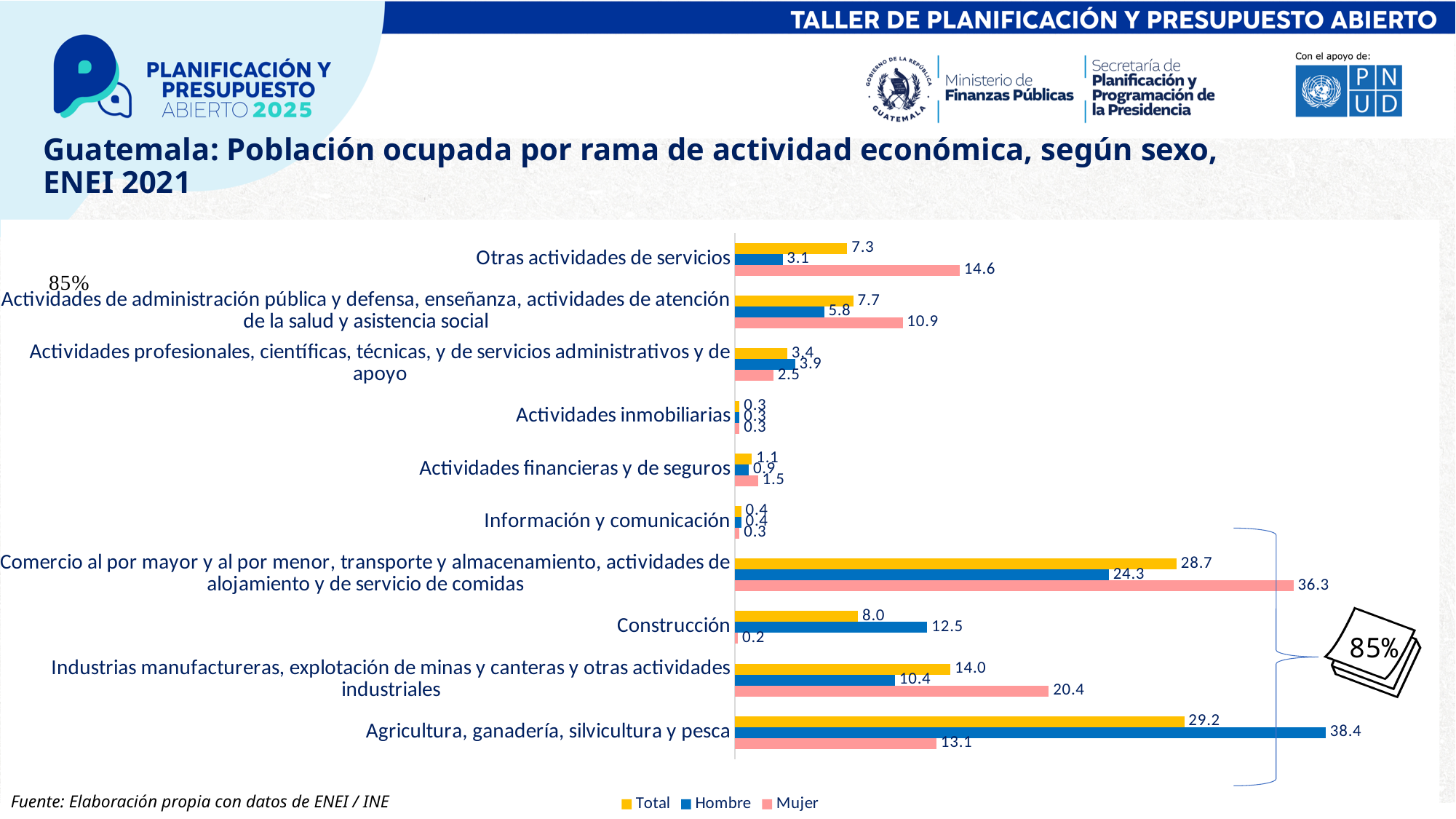
What is the difference between the Mujer and Hombre values for Industrias manufactureras, explotación de minas y canteras y otras actividades industriales? 10.0 What is the Total value for Construcción? 8.0 Which category has the highest Hombre value? Agricultura, ganadería, silvicultura y pesca How many categories (economic activity branches) are shown in the chart? 10 What type of chart is shown on the slide? bar chart How many series does the legend list? 3 Which series is shown in yellow in the legend? Total Which category has the lowest Mujer value? Construcción What is the difference between the Total values for Agricultura, ganadería, silvicultura y pesca and Comercio al por mayor y al por menor, transporte y almacenamiento, actividades de alojamiento y de servicio de comidas? 0.5 What is the Hombre value for Agricultura, ganadería, silvicultura y pesca? 38.4 For Otras actividades de servicios, which is larger, the Hombre value or the Mujer value? Mujer What is the Mujer value for Comercio al por mayor y al por menor, transporte y almacenamiento, actividades de alojamiento y de servicio de comidas? 36.3